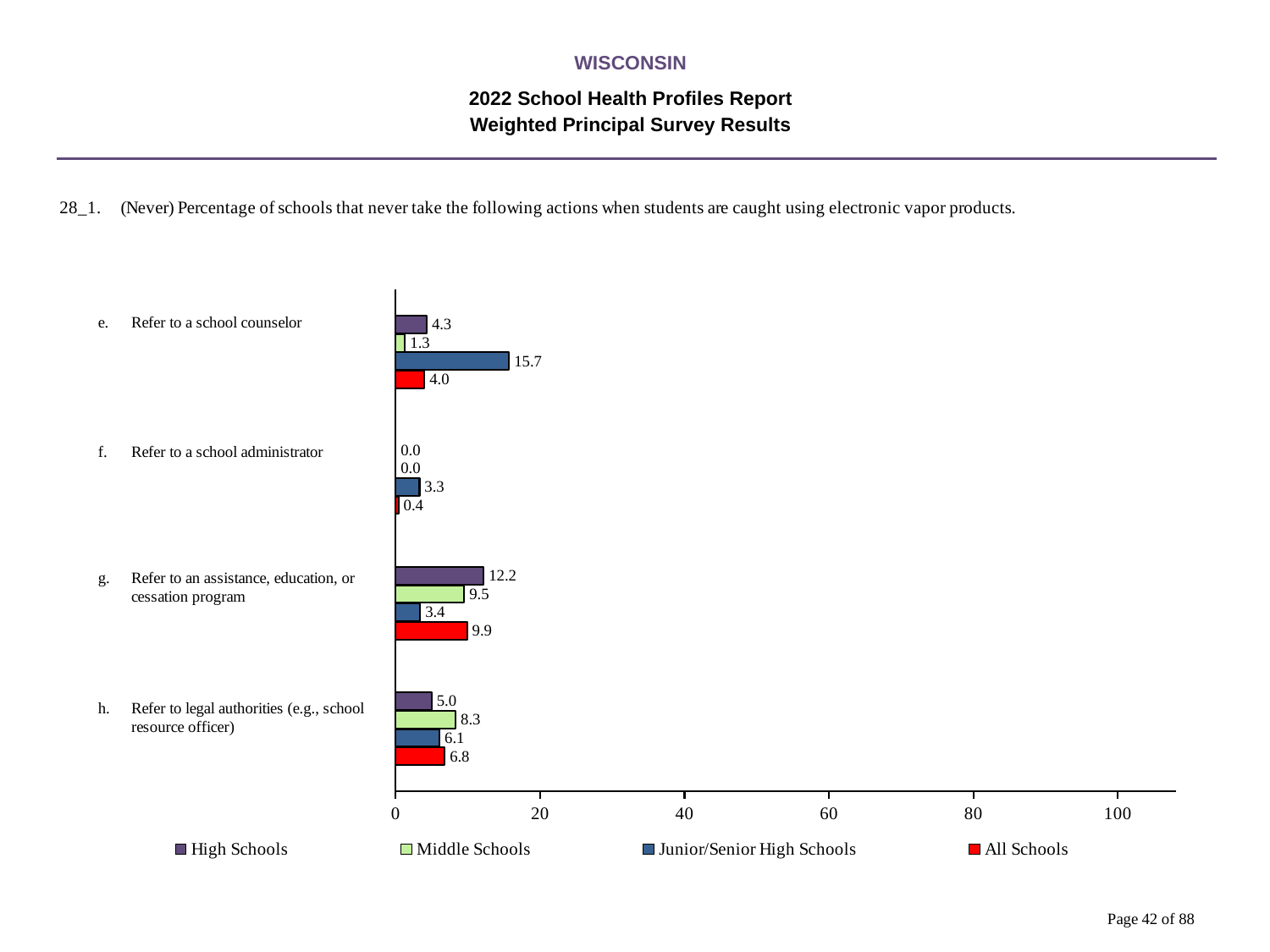
Which category has the lowest value for All Schools? Refer to a school administrator Is the Junior/Senior High Schools value for 'Refer to a school counselor' greater or less than 20? less What is the difference between the Junior/Senior High Schools value and the Middle Schools value for 'Refer to a school counselor'? 14.4 For 'Refer to legal authorities (e.g., school resource officer)', which is larger: the Middle Schools value or the High Schools value? Middle Schools What is the value for High Schools for 'Refer to a school administrator'? 0.0 How many series does the legend list? 4 How many categories are shown on the chart? 4 What kind of chart is shown on the slide? bar chart What is the value for All Schools for 'Refer to an assistance, education, or cessation program'? 9.9 What is the value for Junior/Senior High Schools for 'Refer to a school counselor'? 15.7 What is the value for Middle Schools for 'Refer to legal authorities (e.g., school resource officer)'? 8.3 Which category has the highest value for High Schools? Refer to an assistance, education, or cessation program